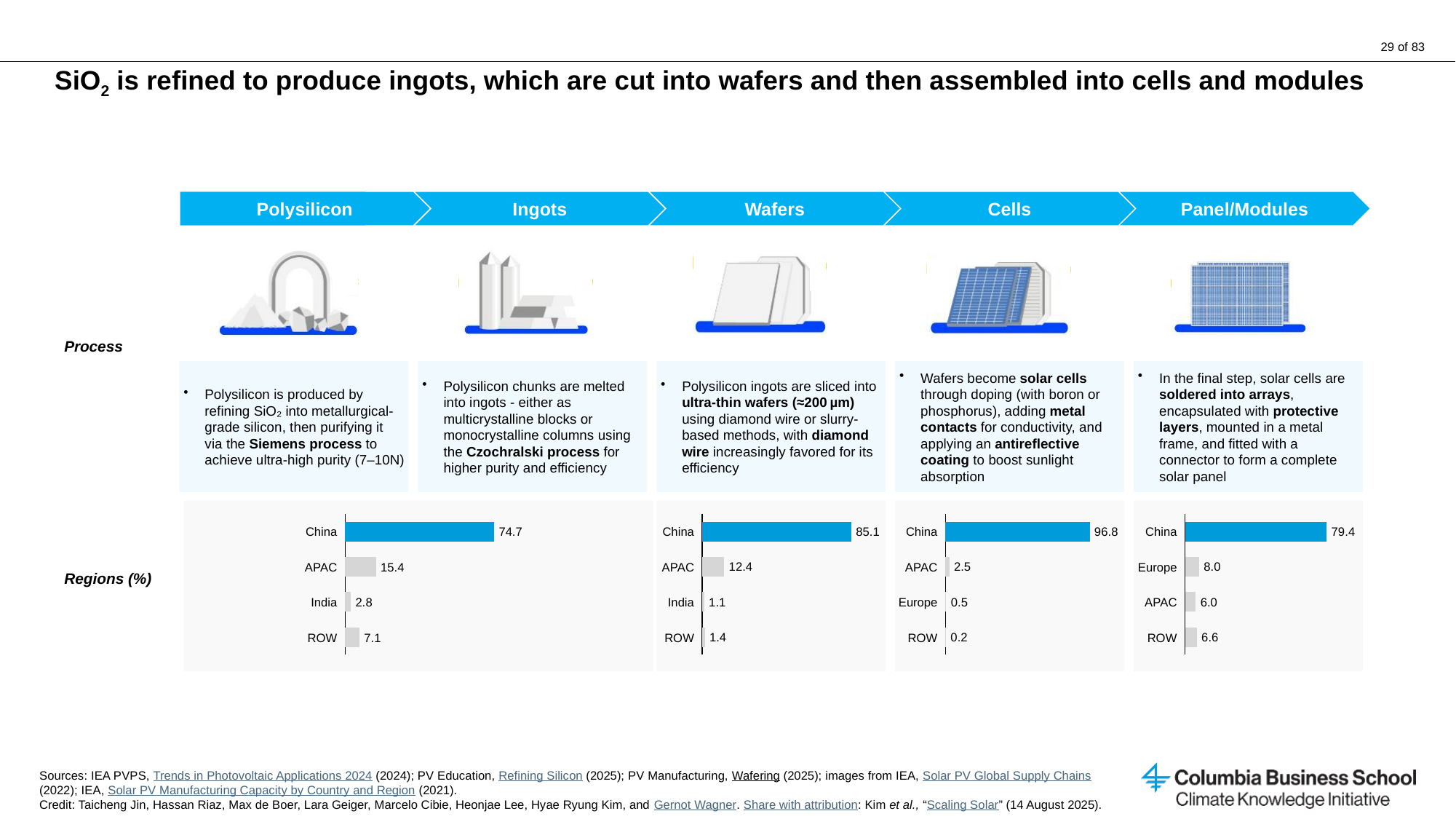
In the Regions (%) chart under Cells, what is the value for Europe? 0.5 In the Regions (%) chart under Panel/Modules, which is larger, the value for Europe or the value for APAC? Europe How many regions are shown in the Regions (%) chart under Cells? 4 In the leftmost Regions (%) chart (under Polysilicon/Ingots), which region has the lowest value? India In the Regions (%) chart under Panel/Modules, what is the value for ROW? 6.6 In the Regions (%) chart under Cells, which region has the highest value? China What type of chart is used for the Regions (%) data under Wafers? Bar chart In the leftmost Regions (%) chart (under Polysilicon/Ingots), what is the value for China? 74.7 In the Regions (%) chart under Wafers, what is the difference between the values for China and APAC? 72.7 How many Regions (%) bar charts are shown on the slide? 4 In the Regions (%) chart under Panel/Modules, what is the difference between the values for China and Europe? 71.4 In the Regions (%) chart under Wafers, what is the value for APAC? 12.4